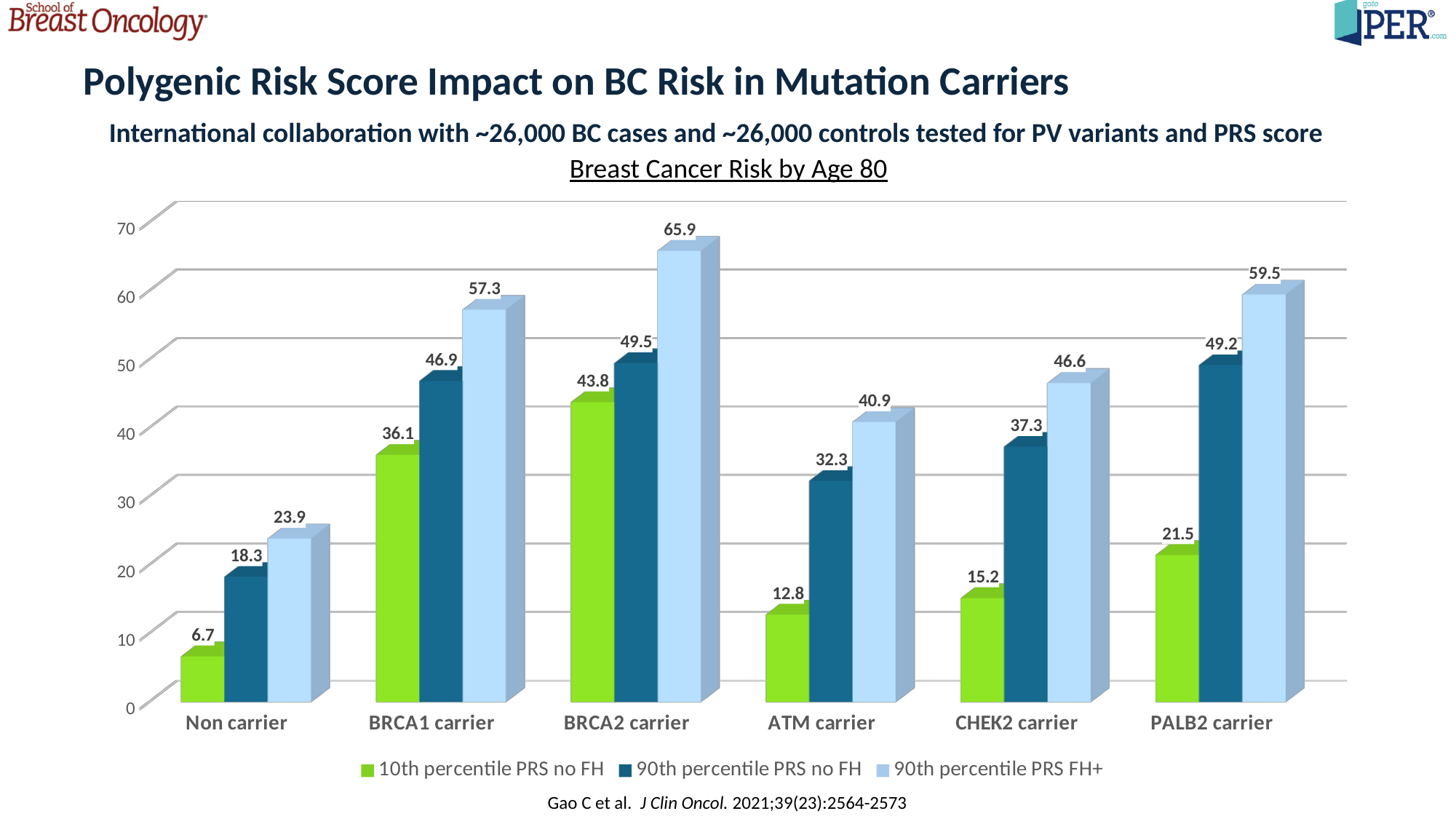
What is the title of the chart? Breast Cancer Risk by Age 80 What is the value for Non carrier in the 10th percentile PRS no FH series? 6.7 What is the value for BRCA2 carrier in the 90th percentile PRS FH+ series? 65.9 How many carrier categories are shown on the x axis? 6 Which is larger: the 90th percentile PRS no FH value for CHEK2 carrier or for ATM carrier? CHEK2 carrier What is the value for PALB2 carrier in the 90th percentile PRS no FH series? 49.2 Which category has the highest value in the 90th percentile PRS FH+ series? BRCA2 carrier Which category has the lowest value in the 10th percentile PRS no FH series? Non carrier What is the difference between the 90th percentile PRS FH+ and 10th percentile PRS no FH values for BRCA1 carrier? 21.2 What kind of chart is shown on the slide? Bar chart Which series is shown in green? 10th percentile PRS no FH How many series does the legend list? 3